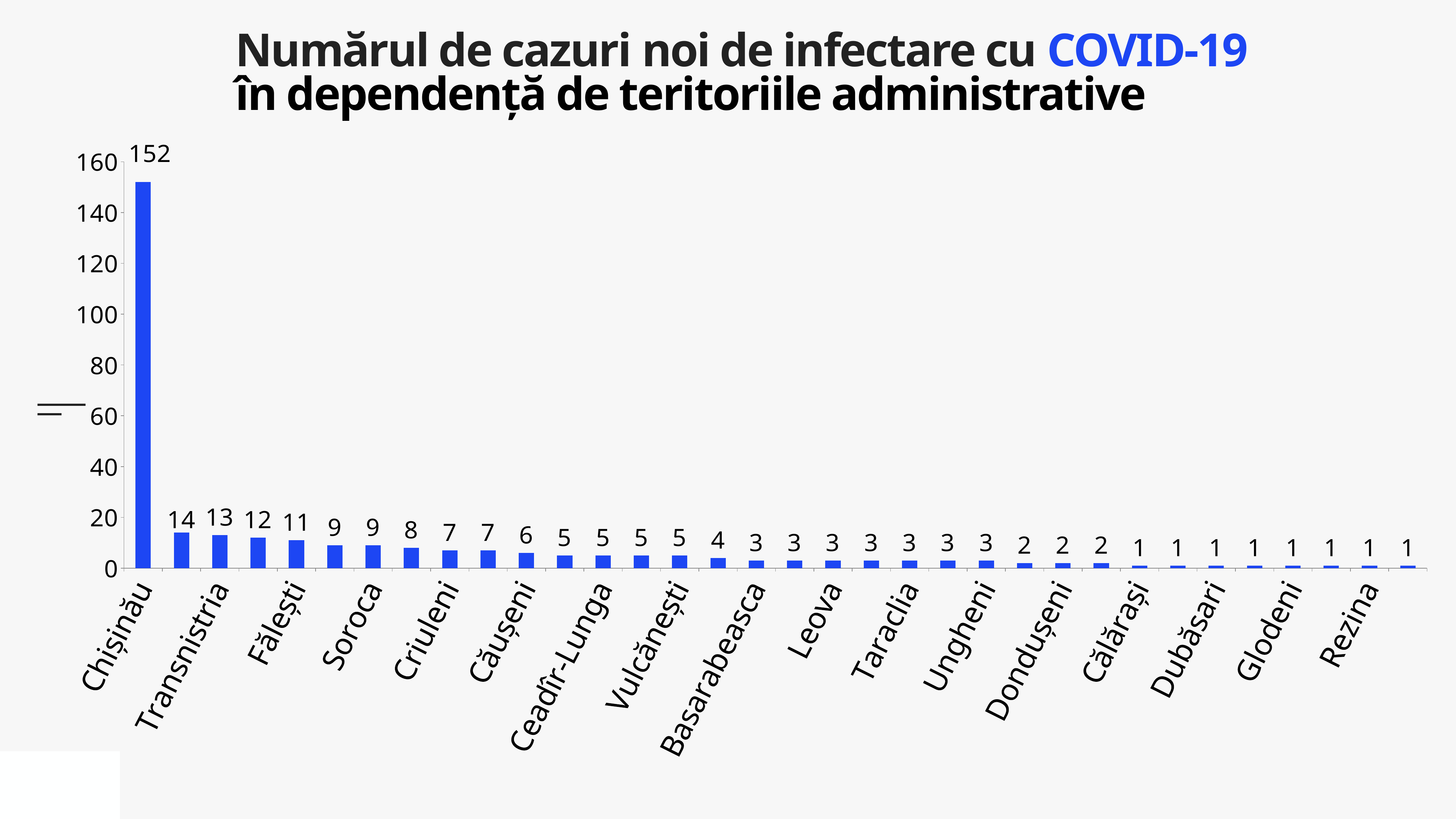
What is the value for Chișinău? 152 How many bars have a value of 1? 8 What is the difference between the tallest bar (152) and the bar immediately to its right (14)? 138 What is the highest value shown on the vertical axis? 160 Is the value for Chișinău greater or less than 100? greater Which territory has the highest number of new cases? Chișinău What is the smallest value printed on any bar in the chart? 1 What colour are the bars in the chart? blue Is the value for Chișinău greater or less than 140? greater What kind of chart is shown on the slide? bar chart Do the values rise or fall from left to right along the x axis? fall